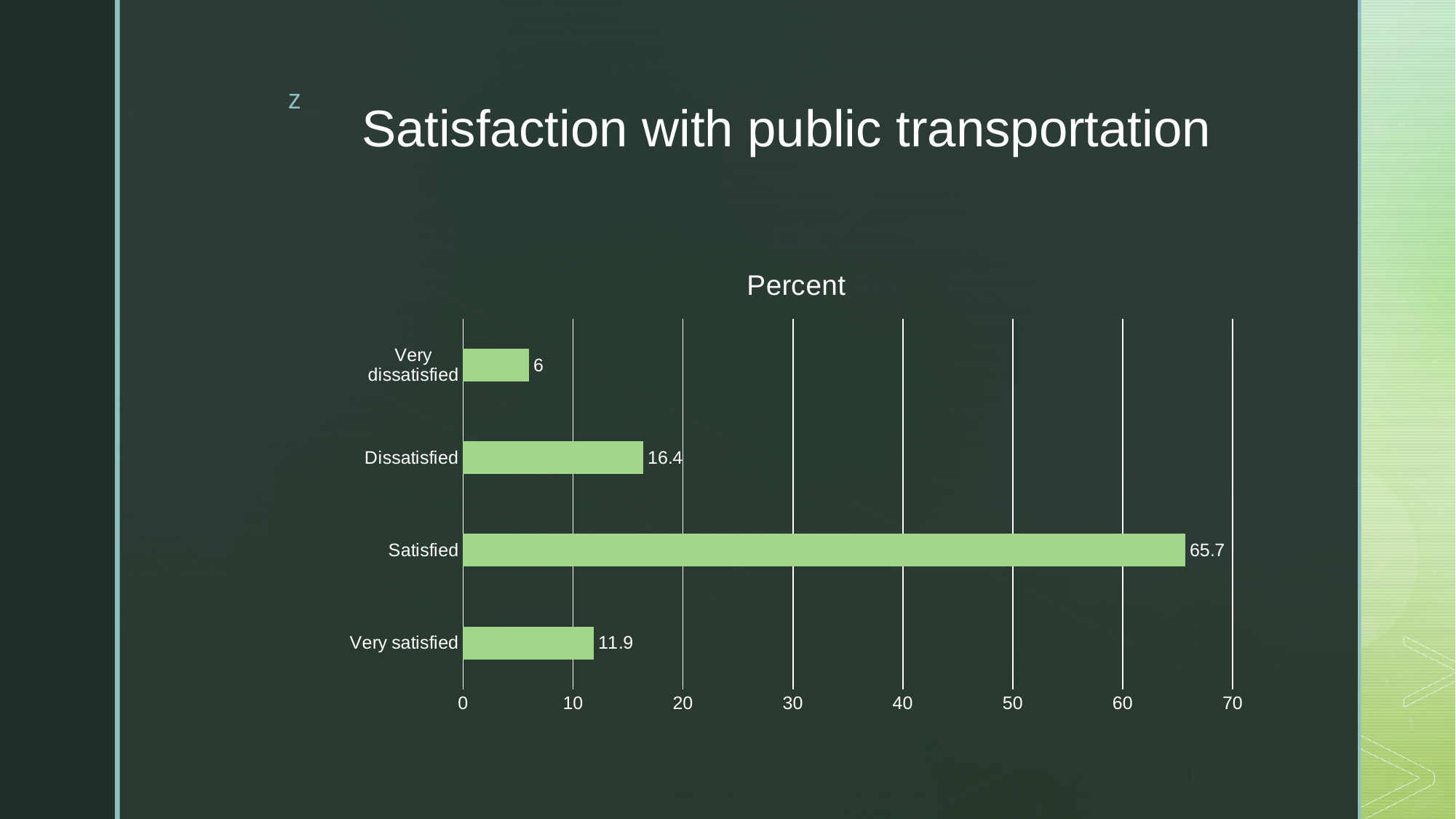
How many categories are shown in the chart? 4 What kind of chart is shown on the slide? Bar chart What is the value for Satisfied? 65.7 What is the value for Very satisfied? 11.9 What is the title of the chart? Percent Which is larger, the value for Dissatisfied or the value for Very satisfied? Dissatisfied What is the value for Very dissatisfied? 6 What is the difference between the values for Dissatisfied and Very satisfied? 4.5 Which category has the highest value? Satisfied What is the value for Dissatisfied? 16.4 Which category has the lowest value? Very dissatisfied What is the difference between the values for Satisfied and Very dissatisfied? 59.7